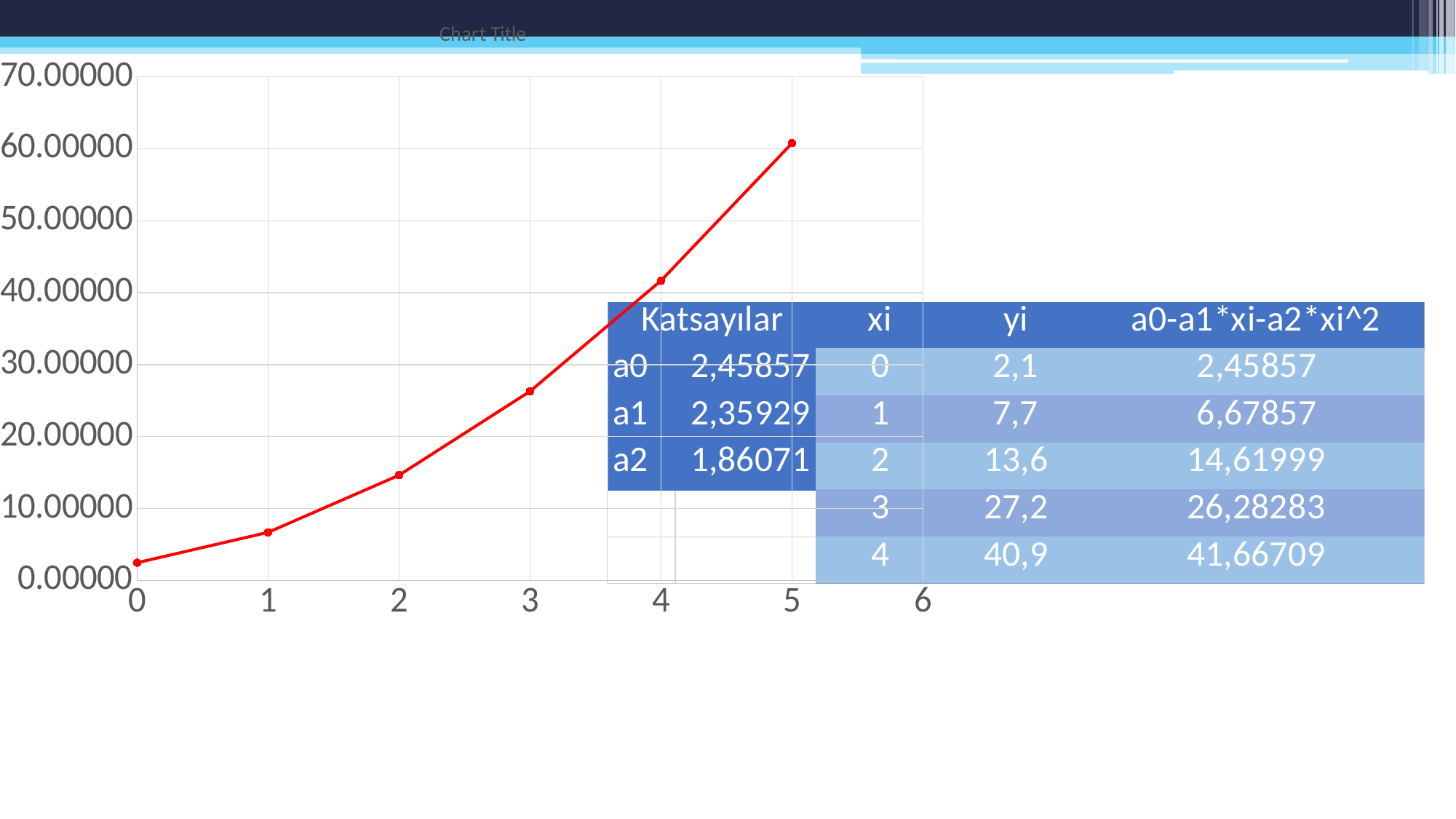
Is the plotted value at x = 3 greater or less than 30? less At which x value is the plotted value highest? 5 Is the plotted value at x = 4 greater or less than 50? less Is the plotted value at x = 5 greater or less than 50? greater What kind of chart is shown on the slide? line chart Do the plotted values rise or fall as x increases from 0 to 5? rise Which has the larger plotted value, x = 3 or x = 4? x = 4 At which x value is the plotted value lowest? 0 How many data points are plotted on the line? 6 What colour is the plotted line? red